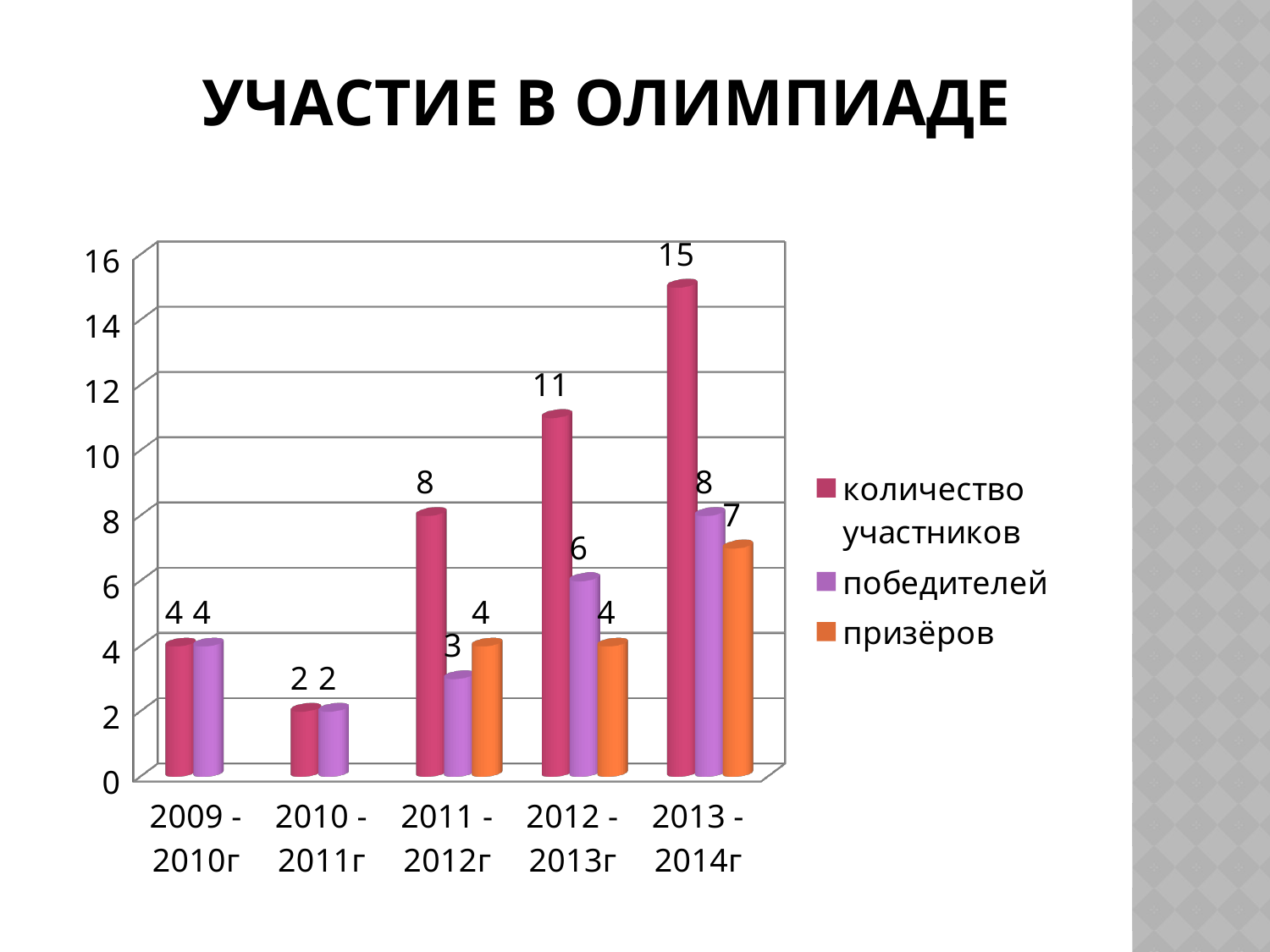
What is the value for победителей in 2012 - 2013г? 6 Which period has the highest value for количество участников? 2013 - 2014г What is the value for призёров in 2011 - 2012г? 4 Does the value for количество участников rise or fall from 2010 - 2011г to 2013 - 2014г? rise How many series does the legend list? 3 What is the value for количество участников in 2013 - 2014г? 15 How many periods are shown on the x axis? 5 What is the difference between количество участников and победителей in 2013 - 2014г? 7 Which period has the lowest value for количество участников? 2010 - 2011г What kind of chart is shown on the slide? bar chart Which is larger in 2011 - 2012г: победителей or призёров? призёров What is the title of the slide? УЧАСТИЕ В ОЛИМПИАДЕ